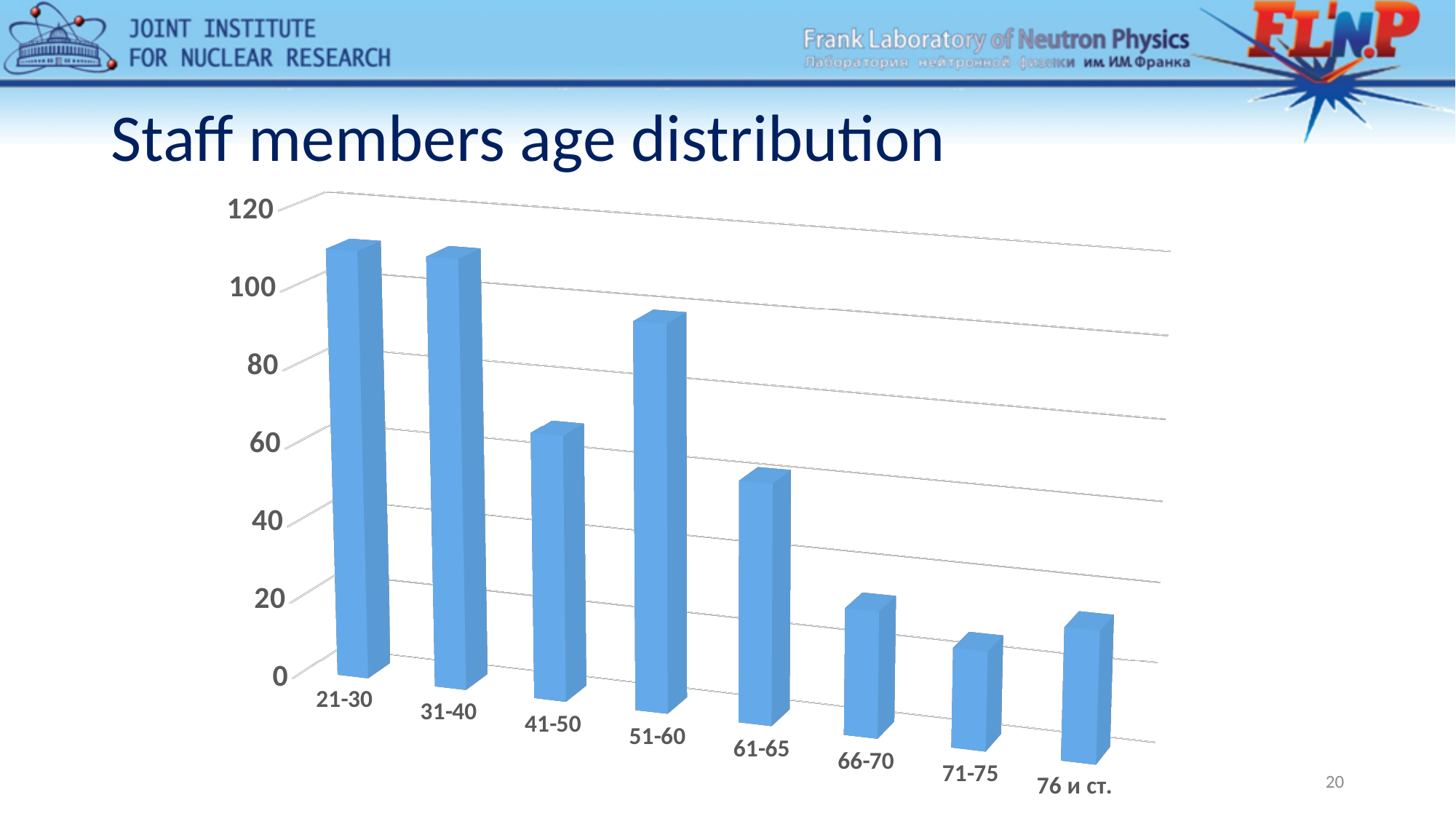
Do the values rise or fall from the 51-60 group to the 71-75 group? fall Is the value for the 51-60 age group greater or less than 80? greater What kind of chart is shown on the slide? bar chart Is the value for the 21-30 age group greater or less than 100? greater How many age categories are shown on the x axis? 8 Is the value for the 31-40 age group greater or less than 100? greater Which age group has the larger value, 41-50 or 51-60? 51-60 Which age group has the larger value, 61-65 or 66-70? 61-65 What is the title of the chart? Staff members age distribution